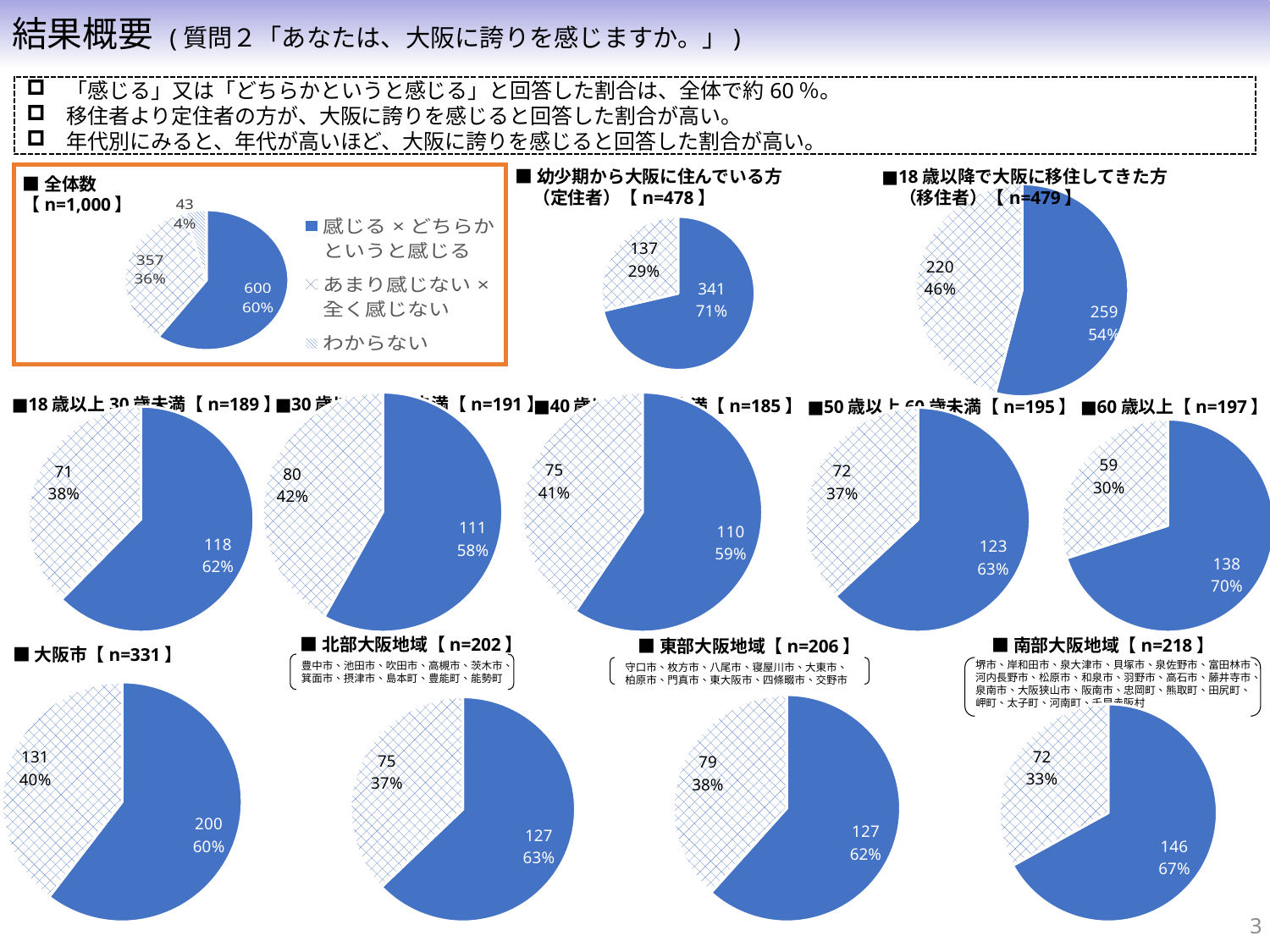
Among the five age-group charts in the middle row, which has the highest solid blue percentage? 60歳以上【n=197】 In the 南部大阪地域【n=218】 chart, what percentage is shown for the hatched slice? 33% In the 18歳以上30歳未満【n=189】 chart, what is the difference in count between the solid blue slice (118) and the hatched slice (71)? 47 In the 全体数【n=1,000】 chart, how many respondents answered わからない? 43 What kind of chart is used for the 全体数【n=1,000】 data? Pie chart In the 大阪市【n=331】 chart, what is the total of the two slice counts (200 and 131)? 331 How many entries does the legend of the 全体数【n=1,000】 chart list? 3 Which chart shows a larger solid blue share: 幼少期から大阪に住んでいる方（定住者）【n=478】 or 18歳以降で大阪に移住してきた方（移住者）【n=479】? 幼少期から大阪に住んでいる方（定住者）【n=478】 In the 全体数【n=1,000】 chart, what percentage of respondents answered 感じる×どちらかというと感じる? 60% In the 18歳以降で大阪に移住してきた方（移住者）【n=479】 chart, how many respondents are in the hatched slice? 220 In the 幼少期から大阪に住んでいる方（定住者）【n=478】 chart, what percentage is shown for the solid blue slice? 71% In the 60歳以上【n=197】 chart, what is the count for the solid blue slice? 138